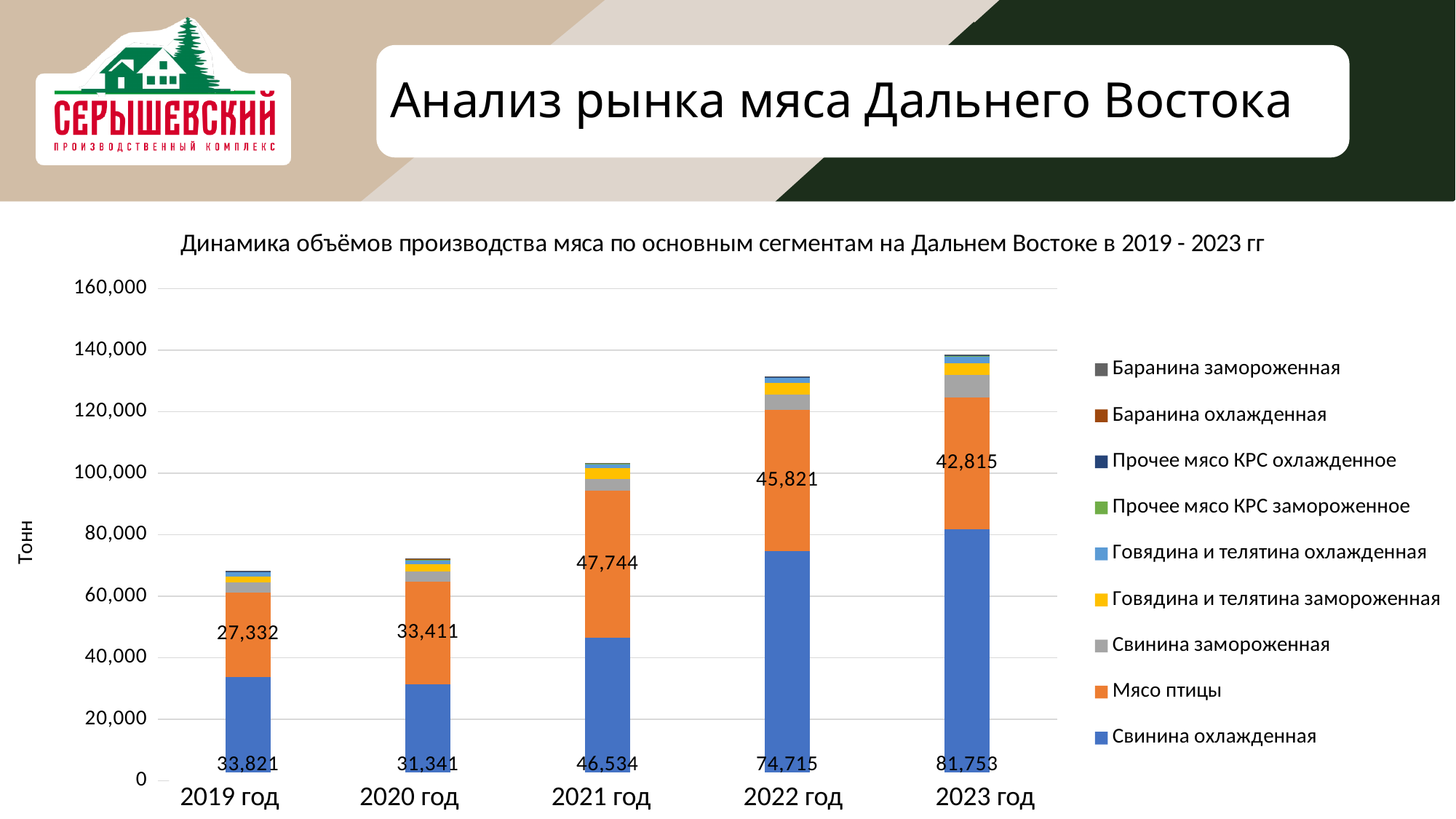
In which year is the value for Мясо птицы highest? 2021 год What is the value for Свинина охлажденная in 2019 год? 33,821 In which year is the value for Свинина охлажденная lowest? 2020 год What is the difference between the Свинина охлажденная values for 2023 год and 2022 год? 7,038 Is the total height of the stacked bar for 2023 год greater or less than 120,000? greater How many years are shown on the x axis? 5 How many series does the legend list? 9 In 2022 год, which is larger: Свинина охлажденная or Мясо птицы? Свинина охлажденная What is the difference between the Мясо птицы values for 2021 год and 2020 год? 14,333 Do the total heights of the stacked bars rise or fall from 2019 год to 2023 год? rise What is the value for Свинина охлажденная in 2023 год? 81,753 What is the value for Мясо птицы in 2022 год? 45,821